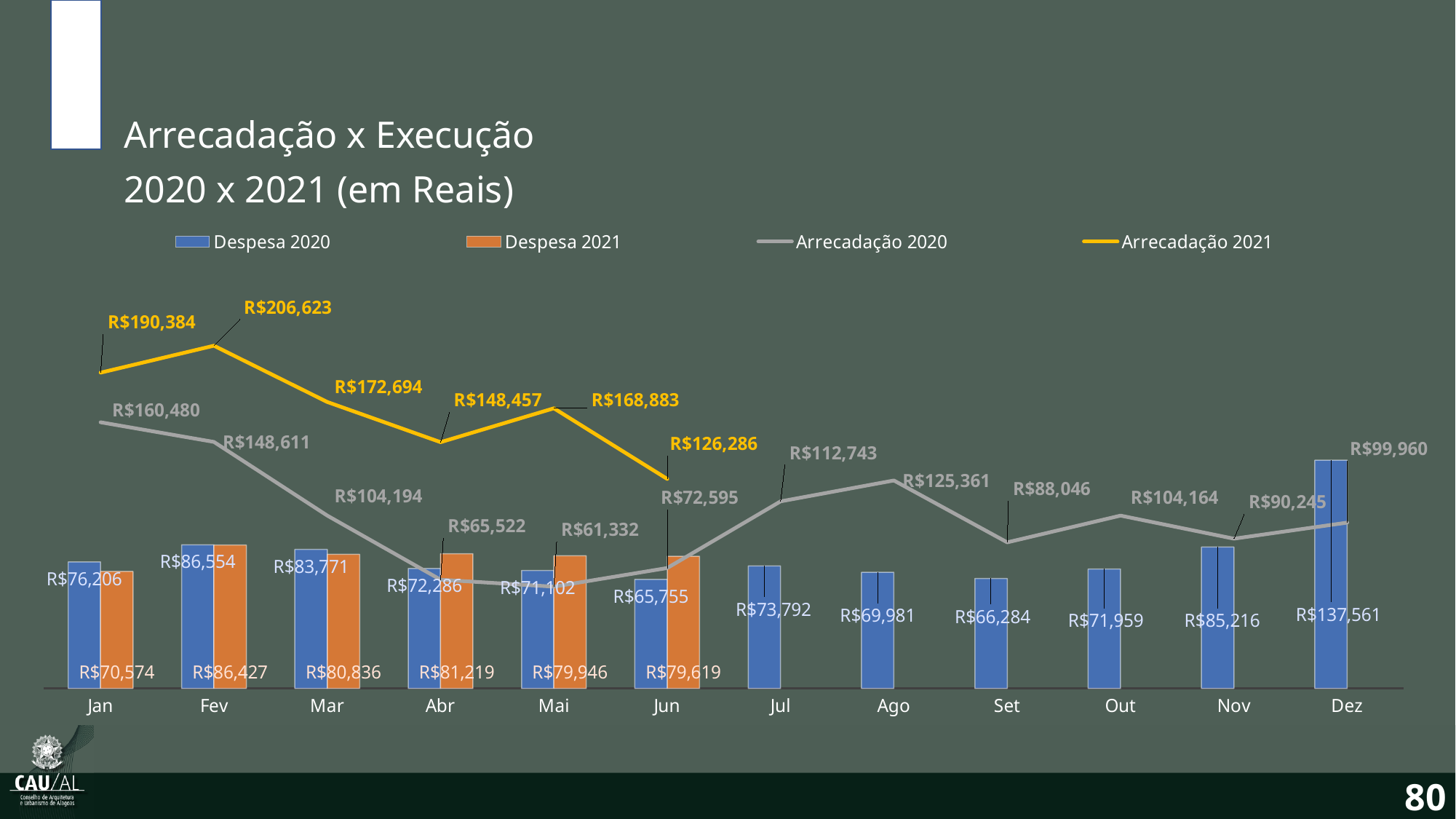
How many series does the legend list? 4 In which month is Despesa 2020 highest? Dez What kind of chart is shown on the slide? A combined bar and line chart What is the value of Arrecadação 2021 in Fev? R$206,623 Does Arrecadação 2021 rise or fall from Fev to Abr? Fall In which month is Arrecadação 2020 lowest? Mai What is the difference between Despesa 2020 in Dez and Despesa 2020 in Nov? R$52,345 How many months are shown along the x axis? 12 What is the difference between Arrecadação 2021 and Arrecadação 2020 in Jan? R$29,904 In Abr, which is larger: Despesa 2020 or Despesa 2021? Despesa 2021 What is the value of Despesa 2021 in Jun? R$79,619 In which month is Arrecadação 2021 highest? Fev